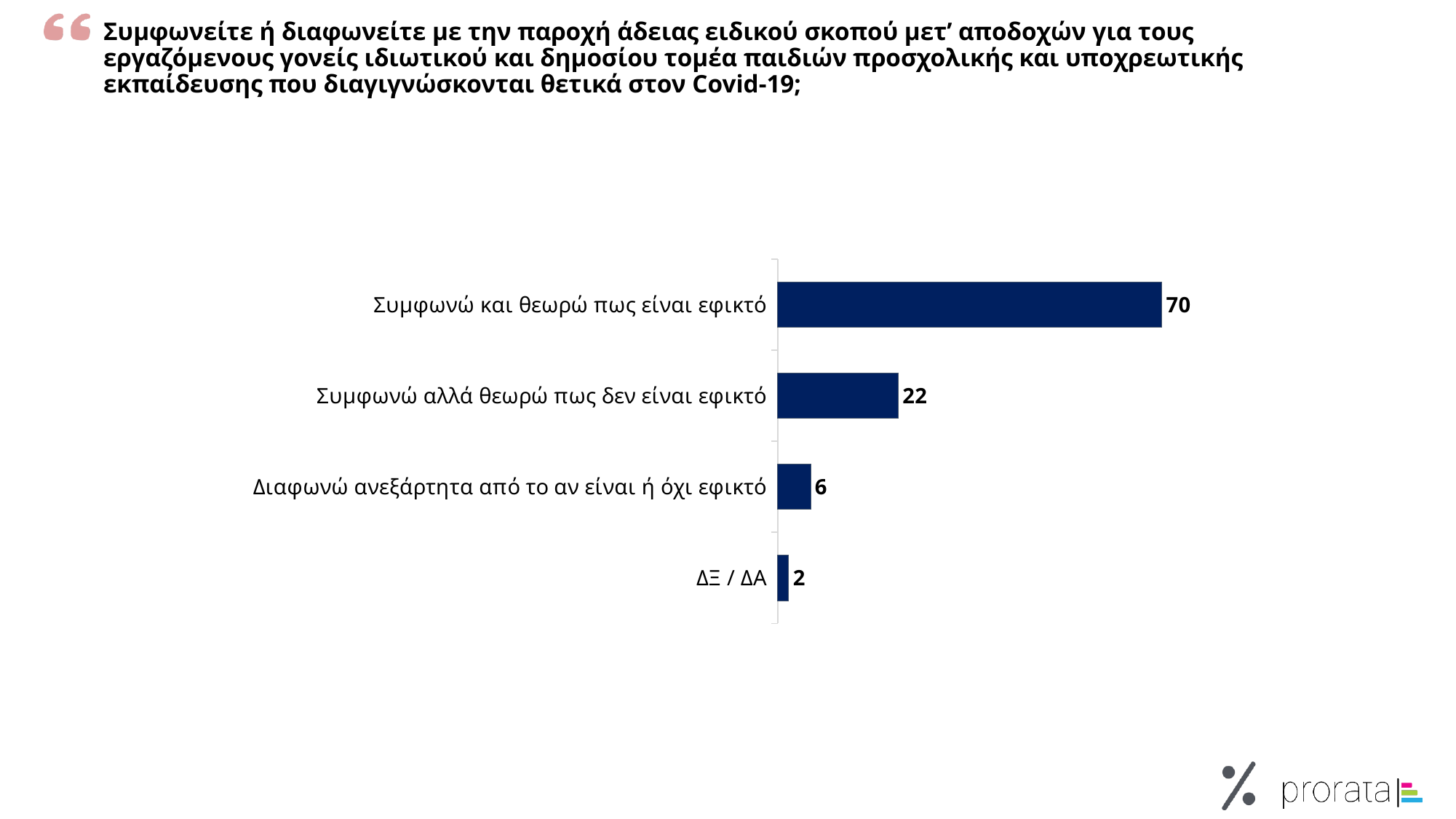
What is the difference between the values for "Διαφωνώ ανεξάρτητα από το αν είναι ή όχι εφικτό" and "ΔΞ / ΔΑ"? 4 Which category has the highest value? Συμφωνώ και θεωρώ πως είναι εφικτό What is the difference between the values for "Συμφωνώ και θεωρώ πως είναι εφικτό" and "Συμφωνώ αλλά θεωρώ πως δεν είναι εφικτό"? 48 What kind of chart is shown on the slide? Bar chart Which category has the lowest value? ΔΞ / ΔΑ What is the value for "Συμφωνώ αλλά θεωρώ πως δεν είναι εφικτό"? 22 What is the value for "ΔΞ / ΔΑ"? 2 What is the value for "Διαφωνώ ανεξάρτητα από το αν είναι ή όχι εφικτό"? 6 How many categories are shown in the chart? 4 What colour are the bars in the chart? Dark blue What is the value for "Συμφωνώ και θεωρώ πως είναι εφικτό"? 70 Which is larger: the value for "Συμφωνώ αλλά θεωρώ πως δεν είναι εφικτό" or the value for "Διαφωνώ ανεξάρτητα από το αν είναι ή όχι εφικτό"? Συμφωνώ αλλά θεωρώ πως δεν είναι εφικτό